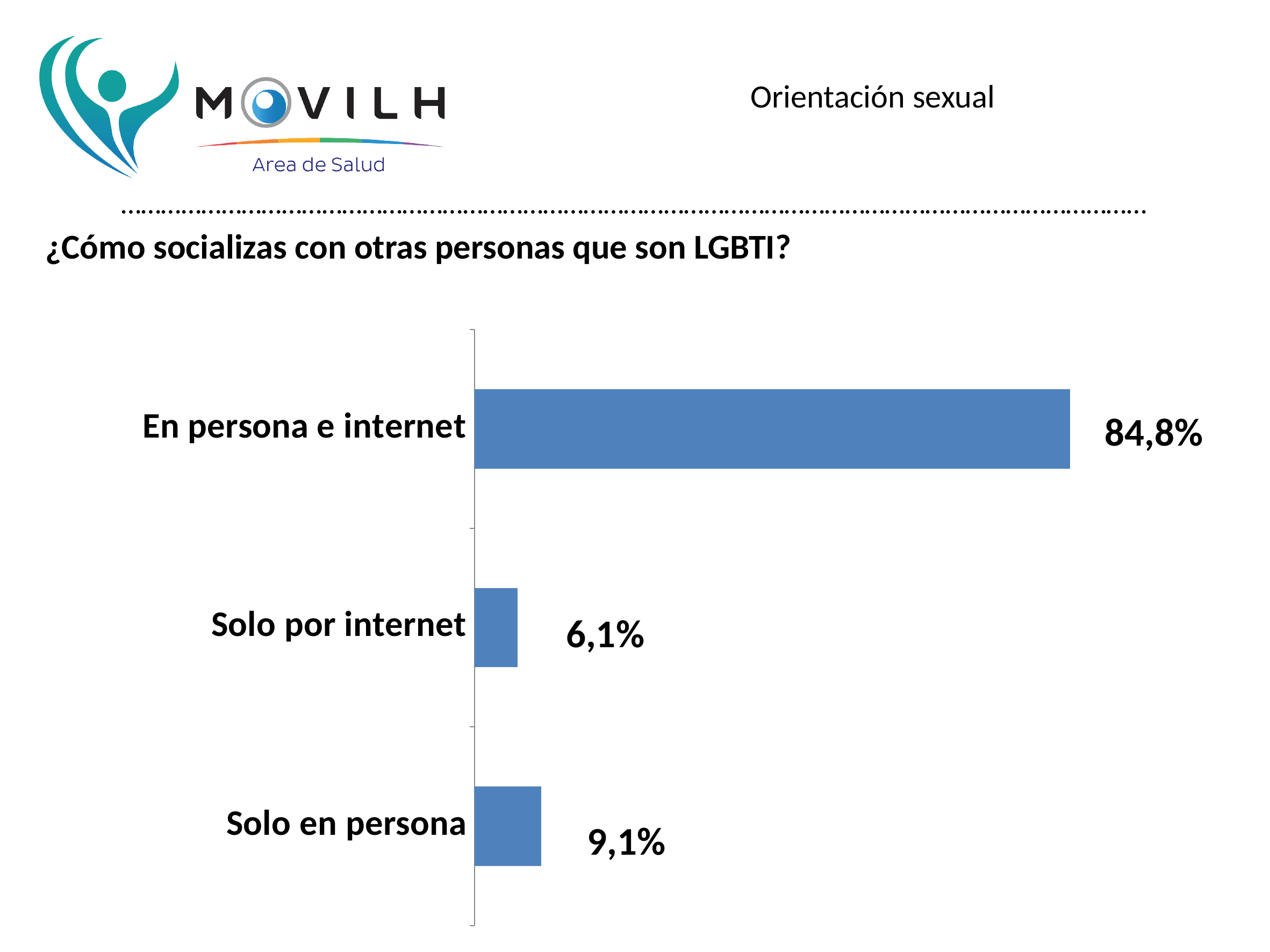
What question does the chart answer, as written above it? ¿Cómo socializas con otras personas que son LGBTI? Which category has the highest value? En persona e internet What colour are the bars in the chart? Blue How many categories are shown in the chart? 3 What kind of chart is shown on the slide? Bar chart Which category has the lowest value? Solo por internet What is the value for "Solo por internet"? 6,1% What is the value for "En persona e internet"? 84,8% What is the difference between the values for "En persona e internet" and "Solo en persona"? 75,7% What is the difference between the values for "Solo en persona" and "Solo por internet"? 3,0% What is the value for "Solo en persona"? 9,1% Which is larger, the value for "Solo en persona" or the value for "Solo por internet"? Solo en persona